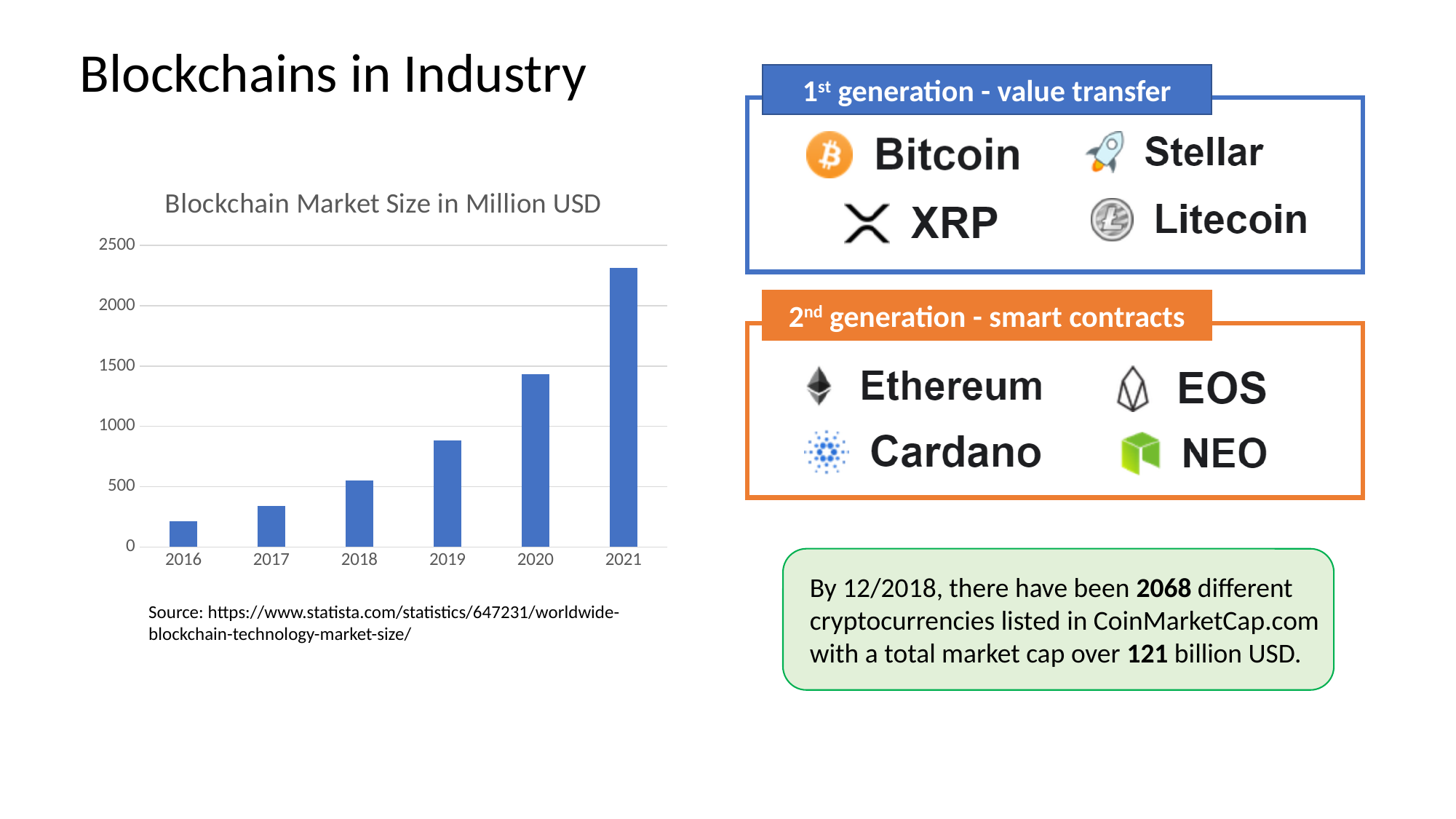
Is the value for 2019 greater or less than 1000? less Which year has the highest blockchain market size? 2021 Is the value for 2021 greater or less than 2000? greater Which year has the lowest blockchain market size? 2016 What type of chart is shown on the slide? bar chart How many years are shown on the x axis of the chart? 6 Which is larger, the value for 2017 or the value for 2019? 2019 Do the values rise or fall from 2016 to 2021? rise What is the first year shown on the x axis of the chart? 2016 What is the title of the chart? Blockchain Market Size in Million USD Is the value for 2020 greater or less than 1500? less